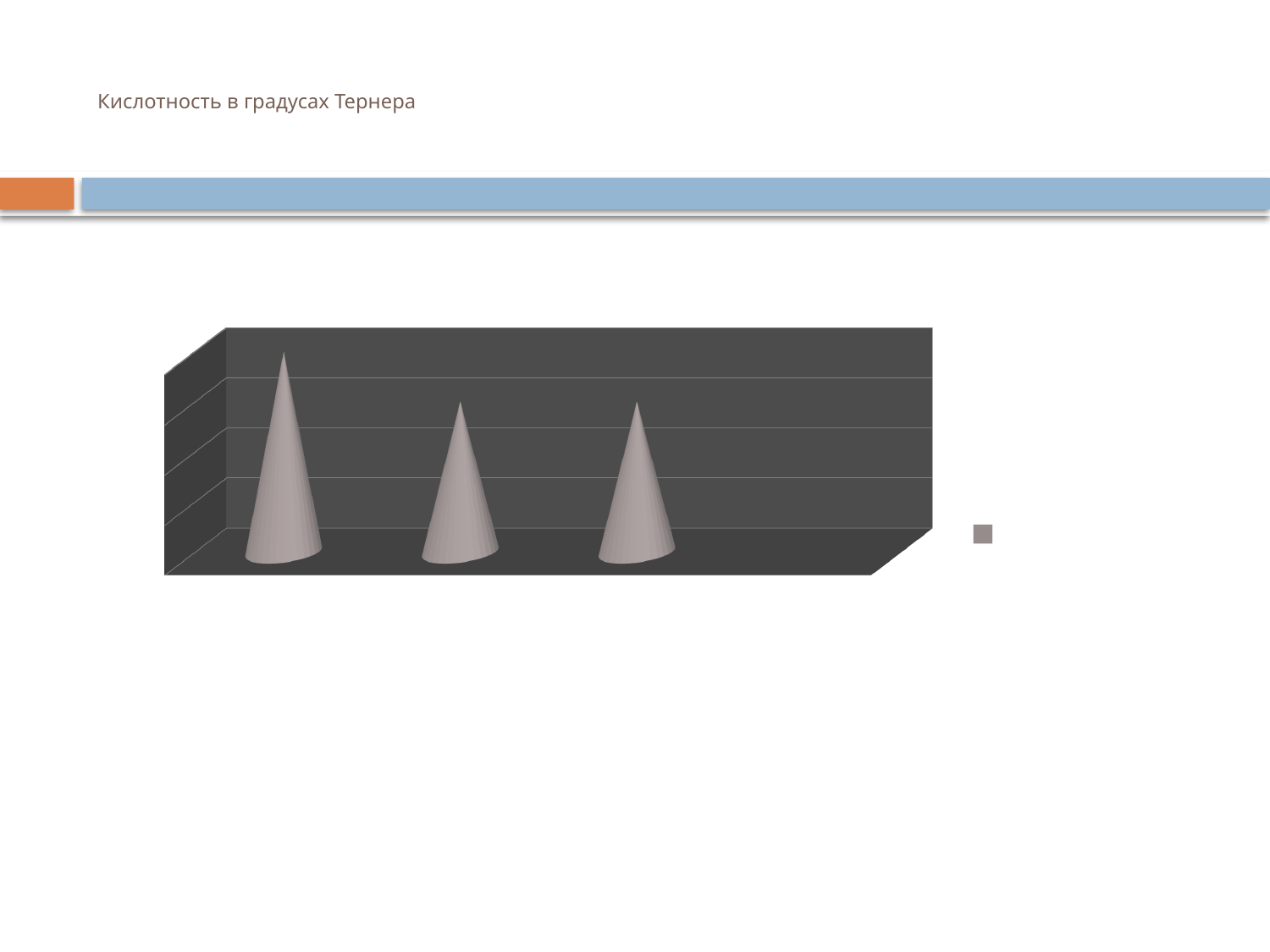
Which bar in the chart is the tallest: the leftmost, the middle, or the rightmost? the leftmost How many bars (cones) are plotted in the chart? 3 Which is taller in the chart, the leftmost bar or the middle bar? the leftmost bar What shape are the bars drawn as in the chart? cones Which is taller in the chart, the leftmost bar or the rightmost bar? the leftmost bar What title is shown at the top of the slide above the chart? Кислотность в градусах Тернера What kind of chart is shown on the slide? bar chart How many series does the chart's legend list? 1